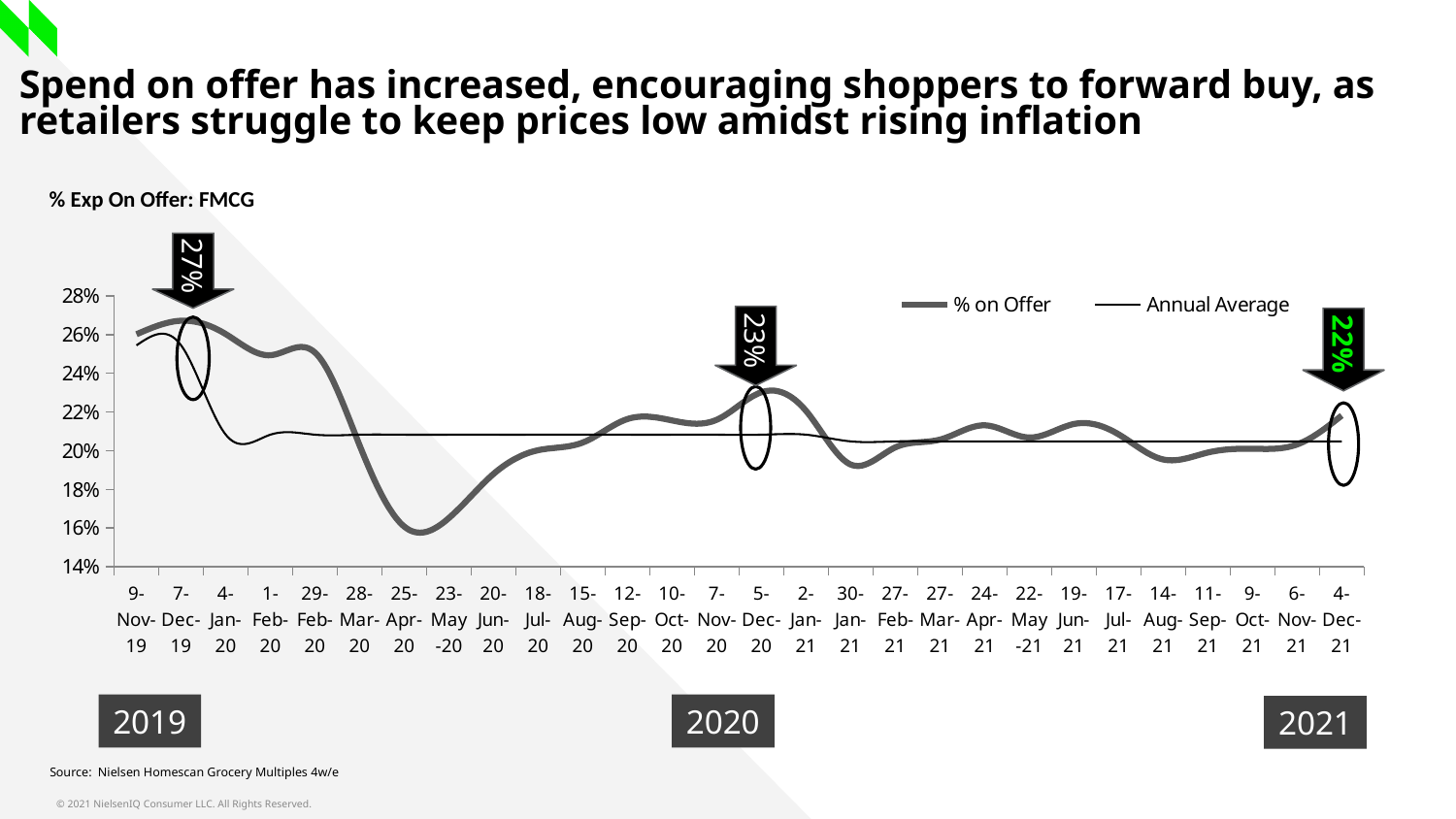
What is the % on Offer value highlighted for 4-Dec-21? 22% How many series does the chart legend list? 2 What is the % on Offer value highlighted for 5-Dec-20? 23% At which date does the % on Offer line reach its highest point? 7-Dec-19 Does the % on Offer line rise or fall between 7-Dec-19 and 25-Apr-20? Fall What kind of chart is shown on the slide? Line chart What is the % on Offer value highlighted for 7-Dec-19? 27% What is the title of the chart? % Exp On Offer: FMCG Which is larger, the highlighted % on Offer value for 7-Dec-19 or for 4-Dec-21? 7-Dec-19 At which date does the % on Offer line reach its lowest point? 25-Apr-20 What is the difference between the highlighted % on Offer values for 7-Dec-19 and 5-Dec-20? 4 percentage points Is the % on Offer value for 25-Apr-20 greater or less than 18%? less